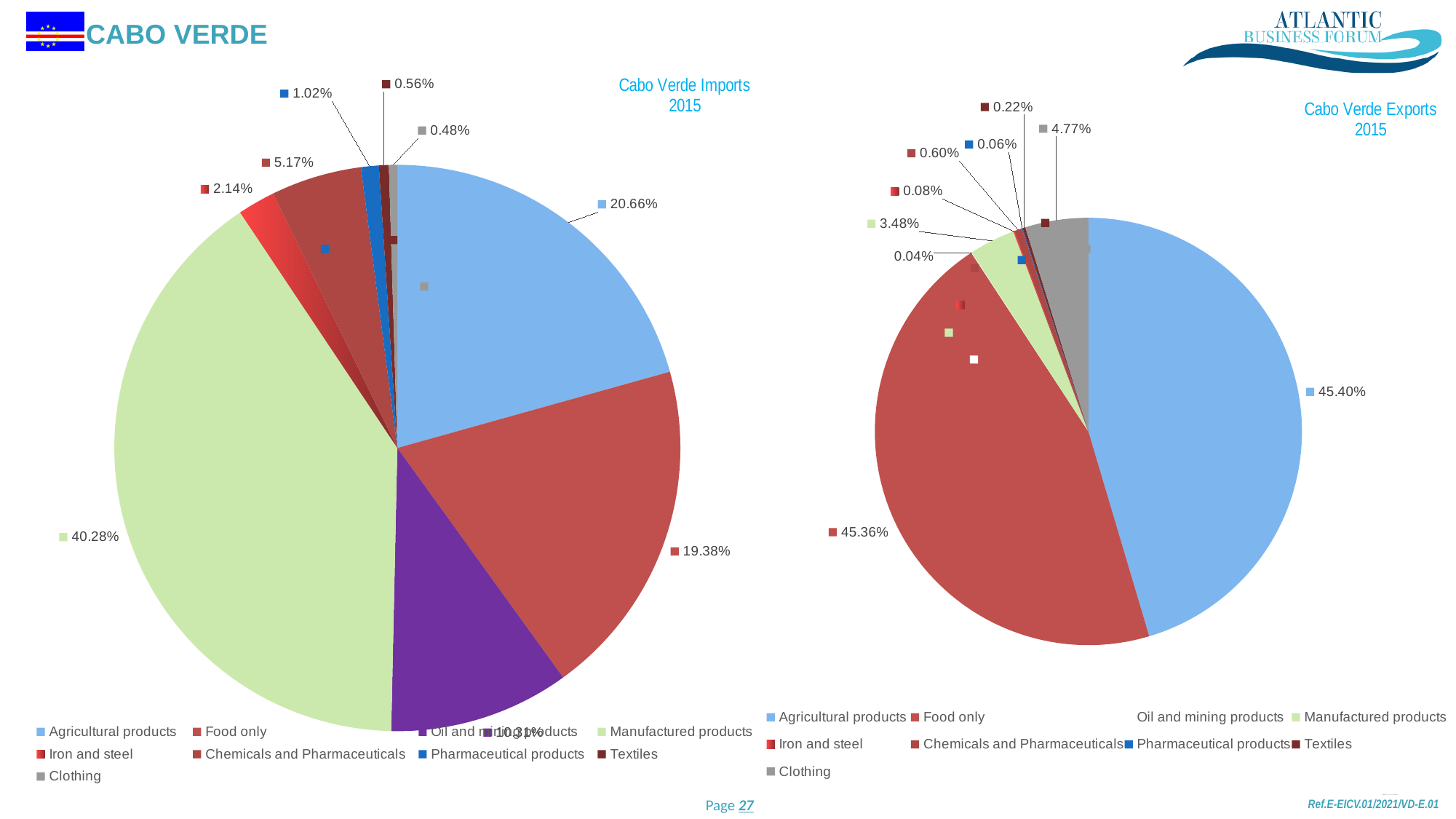
In the Cabo Verde Exports 2015 chart, which category has the smallest share? Oil and mining products In the Cabo Verde Exports 2015 chart, what share does Clothing have? 4.77% In the Cabo Verde Imports 2015 chart, which category has the smallest share? Clothing In the Cabo Verde Imports 2015 chart, what share do Agricultural products have? 20.66% In the Cabo Verde Imports 2015 chart, what is the difference between the shares of Agricultural products and Food only? 1.28% In the Cabo Verde Exports 2015 chart, what share do Agricultural products have? 45.40% How many categories does the legend of the Cabo Verde Exports 2015 chart list? 9 What type of chart is the Cabo Verde Imports 2015 chart? Pie chart In the Cabo Verde Exports 2015 chart, what is the difference between the shares of Clothing and Manufactured products? 1.29% In the Cabo Verde Imports 2015 chart, which category has the largest share? Manufactured products In the Cabo Verde Imports 2015 chart, which is larger: Chemicals and Pharmaceuticals or Iron and steel? Chemicals and Pharmaceuticals In the Cabo Verde Imports 2015 chart, what share do Manufactured products have? 40.28%